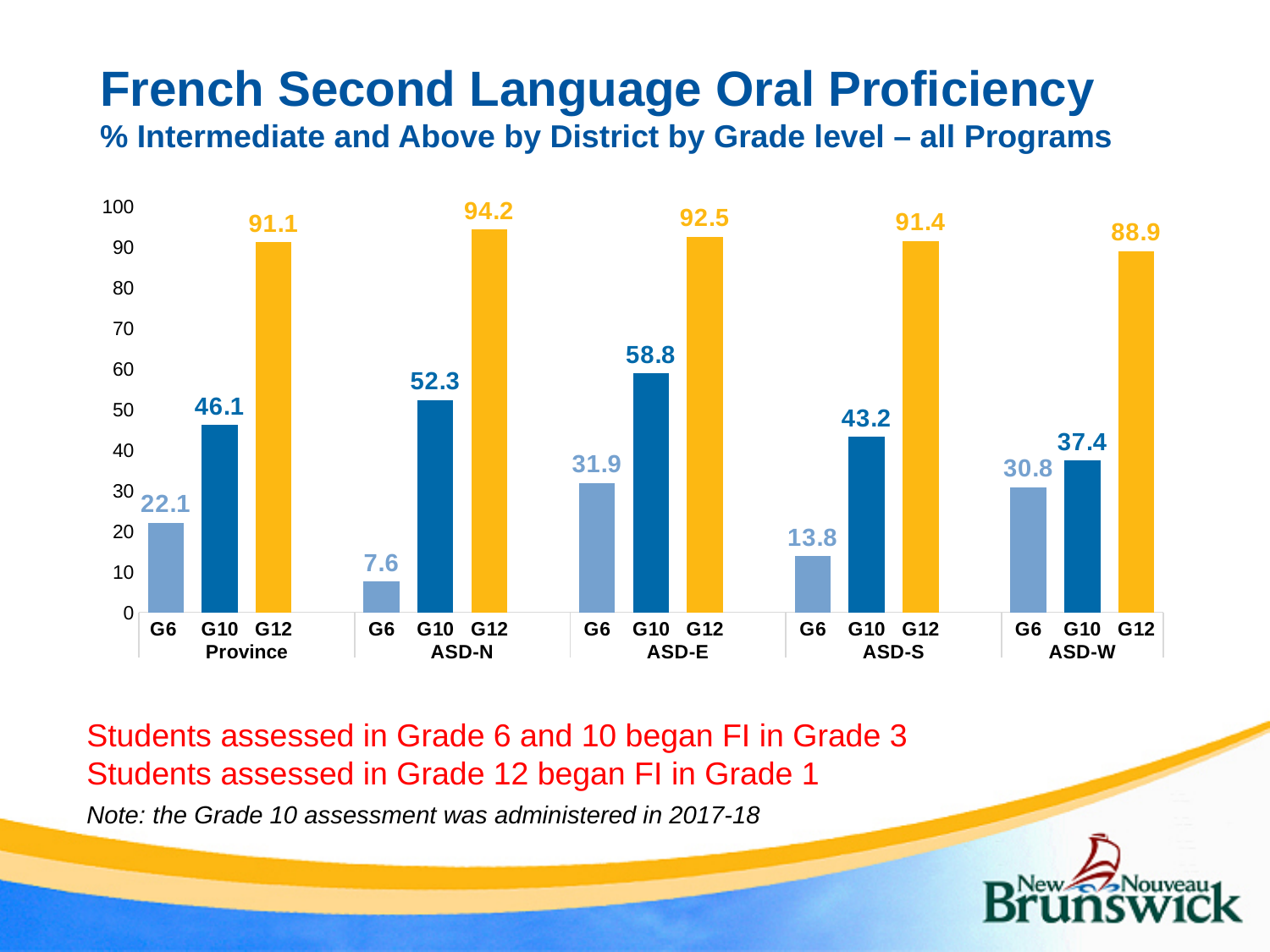
Which district has the highest G12 value? ASD-N Is the value for G6 in ASD-S greater or less than 20? less What kind of chart is shown on the slide? bar chart What is the value for G6 in ASD-N? 7.6 What is the difference between the G12 and G6 values for ASD-S? 77.6 What is the value for G10 in the Province group? 46.1 What is the value for G12 in ASD-E? 92.5 Within each district group, do the values rise or fall from G6 to G12? rise Which district has the lowest G6 value? ASD-N How many district groups are shown on the x axis? 5 Which is larger, the G10 value for ASD-E or the G10 value for ASD-W? ASD-E What is the title of the chart? French Second Language Oral Proficiency